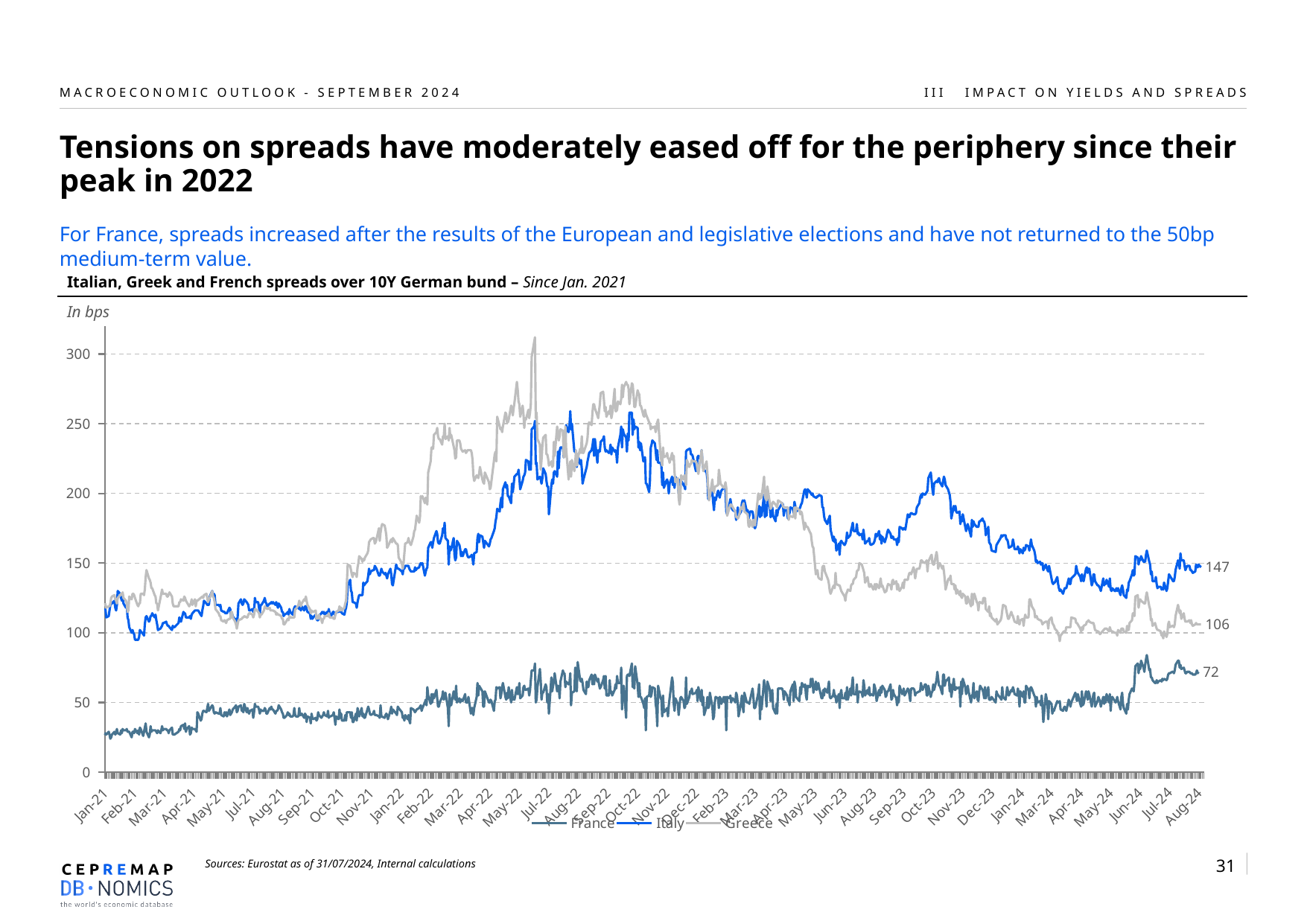
Which series has the lowest value at the right end of the chart? France At the right end of the chart, is the value for Greece larger or smaller than the value for Italy? smaller What kind of chart is shown on the slide? line chart Is the value for France in Jan-21 greater or less than 50? less What is the latest value shown for France at the right end of the chart? 72 How many series does the legend list? 3 What is the difference between the end values of Italy and France? 75 What is the difference between the end values of Italy and Greece? 41 Is the peak value of the Greece series greater or less than 300? greater What is the latest value shown for Greece at the right end of the chart? 106 Which series has the highest value at the right end of the chart? Italy What is the latest value shown for Italy at the right end of the chart? 147